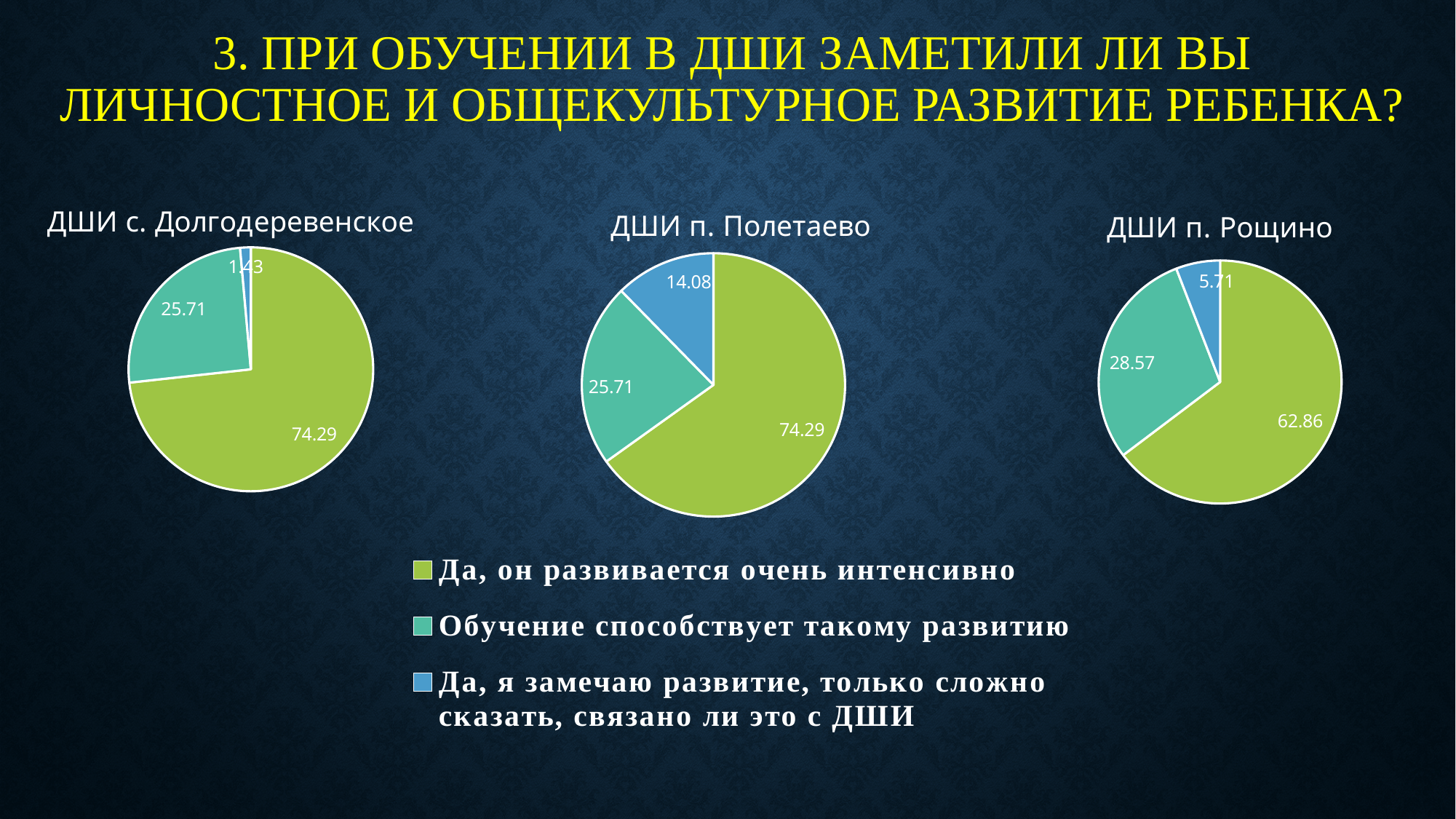
In the chart titled "ДШИ с. Долгодеревенское", what is the value for "Да, он развивается очень интенсивно"? 74.29 In the chart titled "ДШИ п. Полетаево", what is the value for "Да, я замечаю развитие, только сложно сказать, связано ли это с ДШИ"? 14.08 In the chart titled "ДШИ п. Полетаево", which category has the largest slice? Да, он развивается очень интенсивно How many entries does the shared legend list? 3 What type of chart is the chart titled "ДШИ с. Долгодеревенское"? Pie chart In the chart titled "ДШИ п. Полетаево", what is the difference between the values for "Обучение способствует такому развитию" and "Да, я замечаю развитие, только сложно сказать, связано ли это с ДШИ"? 11.63 In the chart titled "ДШИ п. Рощино", what is the difference between the values for "Да, он развивается очень интенсивно" and "Обучение способствует такому развитию"? 34.29 How many slices does the chart titled "ДШИ п. Рощино" have? 3 In the chart titled "ДШИ п. Рощино", what is the value for "Да, он развивается очень интенсивно"? 62.86 Which is larger: the value for "Да, я замечаю развитие, только сложно сказать, связано ли это с ДШИ" in the chart titled "ДШИ п. Полетаево" or in the chart titled "ДШИ п. Рощино"? ДШИ п. Полетаево In the chart titled "ДШИ п. Рощино", what is the value for "Обучение способствует такому развитию"? 28.57 In the chart titled "ДШИ с. Долгодеревенское", which category has the smallest slice? Да, я замечаю развитие, только сложно сказать, связано ли это с ДШИ